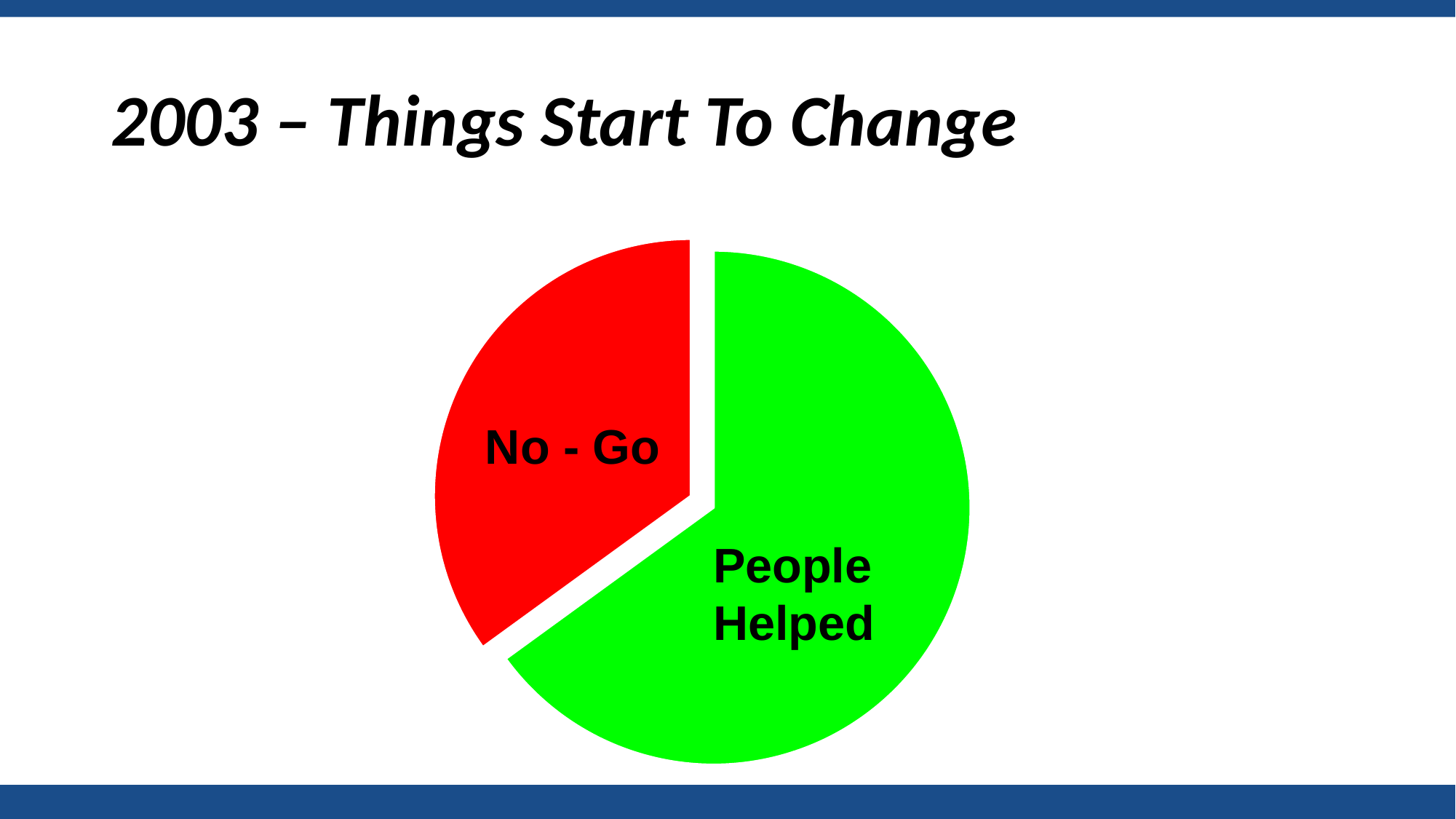
Which slice of the pie chart is the largest? People Helped Which slice is larger, No - Go or People Helped? People Helped How many slices does the pie chart have? 2 What colour is the People Helped slice? green What colour is the No - Go slice? red What kind of chart is shown on the slide? pie chart Which slice of the pie chart is the smallest? No - Go Does the People Helped slice take up more or less than half of the pie? more